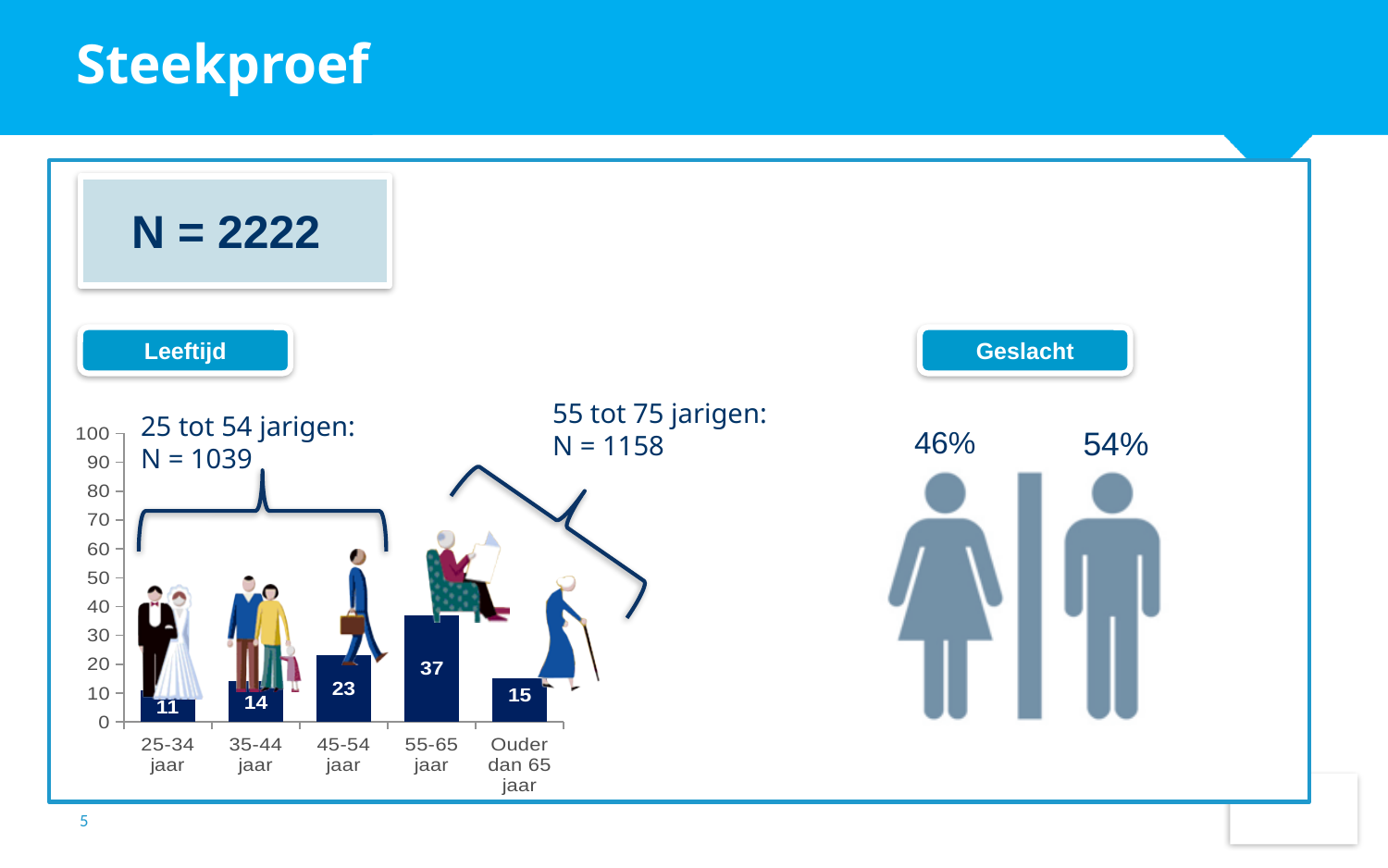
What is the maximum value shown on the vertical axis of the Leeftijd bar chart? 100 What is the value for the Ouder dan 65 jaar category in the Leeftijd bar chart? 15 Which age category has the highest value in the Leeftijd bar chart? 55-65 jaar What is the total of the values for 25-34 jaar, 35-44 jaar and 45-54 jaar in the Leeftijd bar chart? 48 What is the value for the 45-54 jaar category in the Leeftijd bar chart? 23 What is the difference between the values for 55-65 jaar and 45-54 jaar in the Leeftijd bar chart? 14 In the Leeftijd bar chart, which is larger: the value for 35-44 jaar or the value for Ouder dan 65 jaar? Ouder dan 65 jaar What kind of chart is used to show the Leeftijd data? bar chart What is the value for the 25-34 jaar category in the Leeftijd bar chart? 11 How many age categories are shown in the Leeftijd bar chart? 5 Is the value for 55-65 jaar in the Leeftijd bar chart greater or less than 50? less Which age category has the lowest value in the Leeftijd bar chart? 25-34 jaar